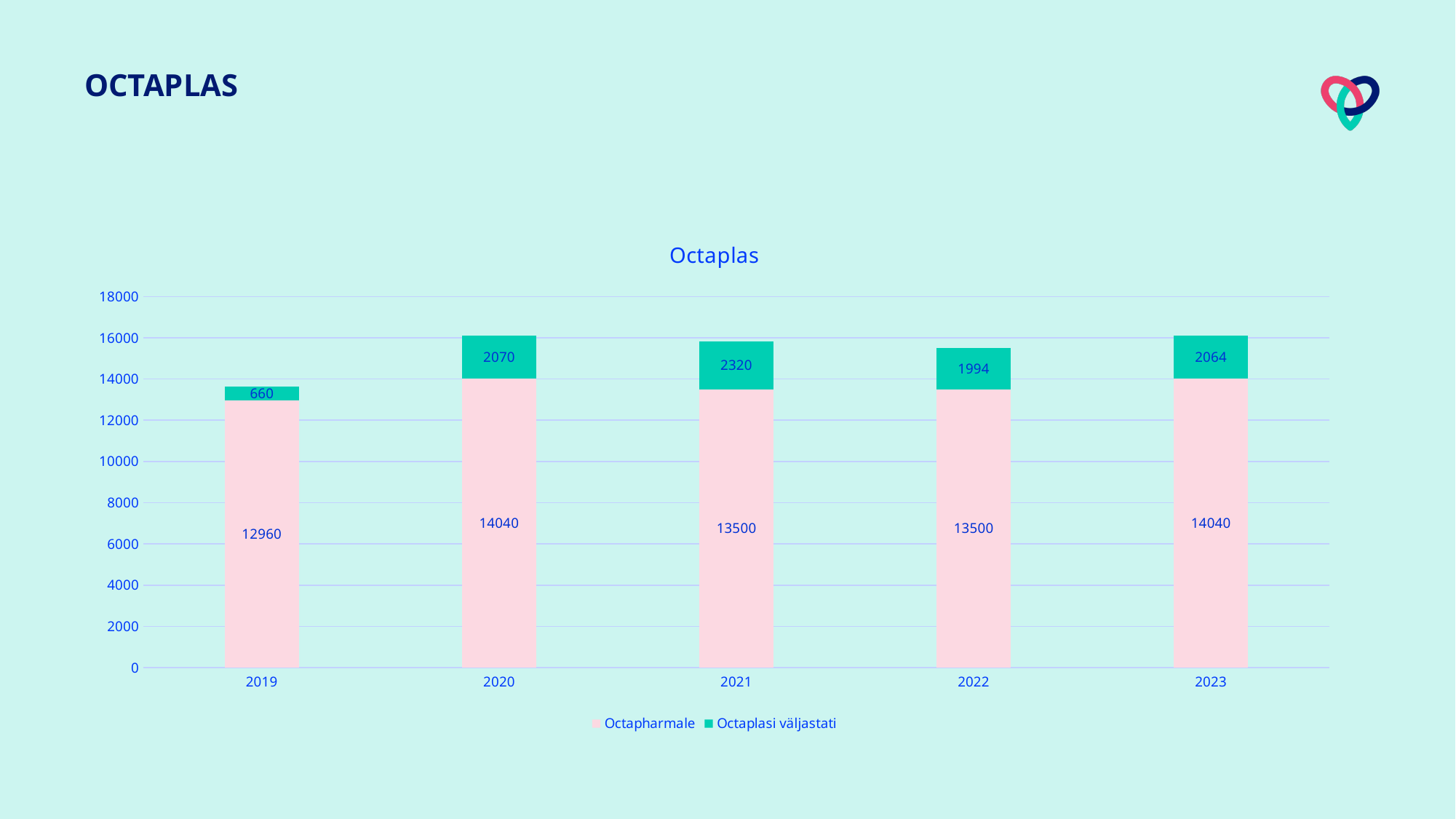
Which year has the highest Octaplasi väljastati value? 2021 What is the Octaplasi väljastati value for 2022? 1994 How many years are shown on the x axis? 5 How many series does the legend list? 2 What is the Octaplasi väljastati value for 2021? 2320 What is the title of the chart? Octaplas Which year has the lowest Octaplasi väljastati value? 2019 What kind of chart is shown on the slide? Stacked bar chart What is the difference between the Octaplasi väljastati values for 2020 and 2019? 1410 Which is larger, the Octapharmale value for 2020 or for 2021? 2020 What is the total of the stacked bar for 2023? 16104 What is the Octapharmale value for 2019? 12960